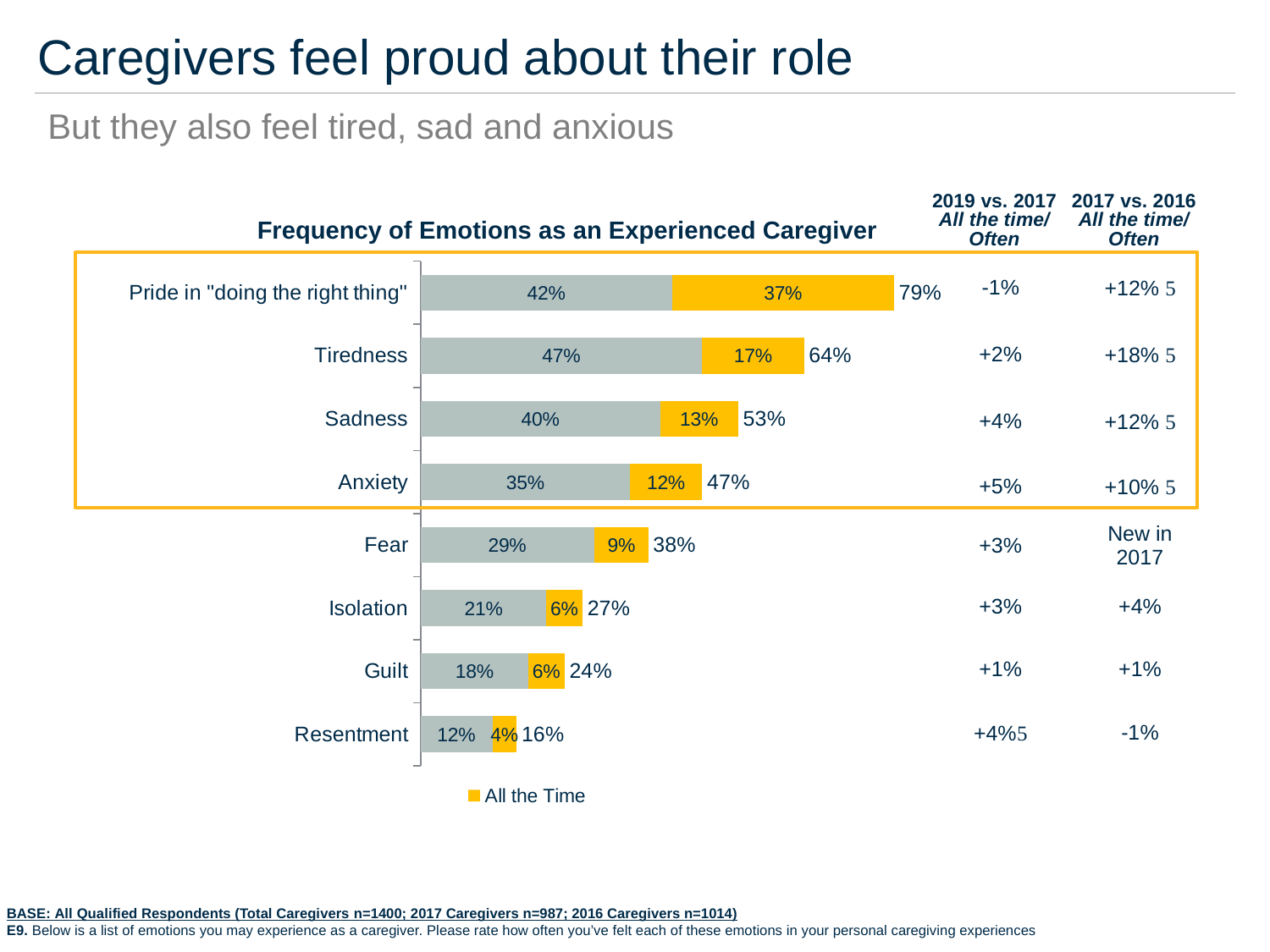
What is the 2019 vs. 2017 change shown for Anxiety? +5% Do the total values rise or fall going down the list of emotions from Pride to Resentment? fall What is the 'All the Time' (yellow) value for Pride in "doing the right thing"? 37% What kind of chart is shown on the slide? bar chart Which emotion has the lowest total frequency? Resentment How many emotions are listed as categories in the chart? 8 Which has a larger 'All the Time' value, Fear or Isolation? Fear Which emotion has the highest total frequency? Pride in "doing the right thing" What is the gray segment value for Tiredness? 47% What is the title of the chart? Frequency of Emotions as an Experienced Caregiver What is the total shown at the end of the Sadness bar? 53% What is the difference between the total for Tiredness and the total for Anxiety? 17%